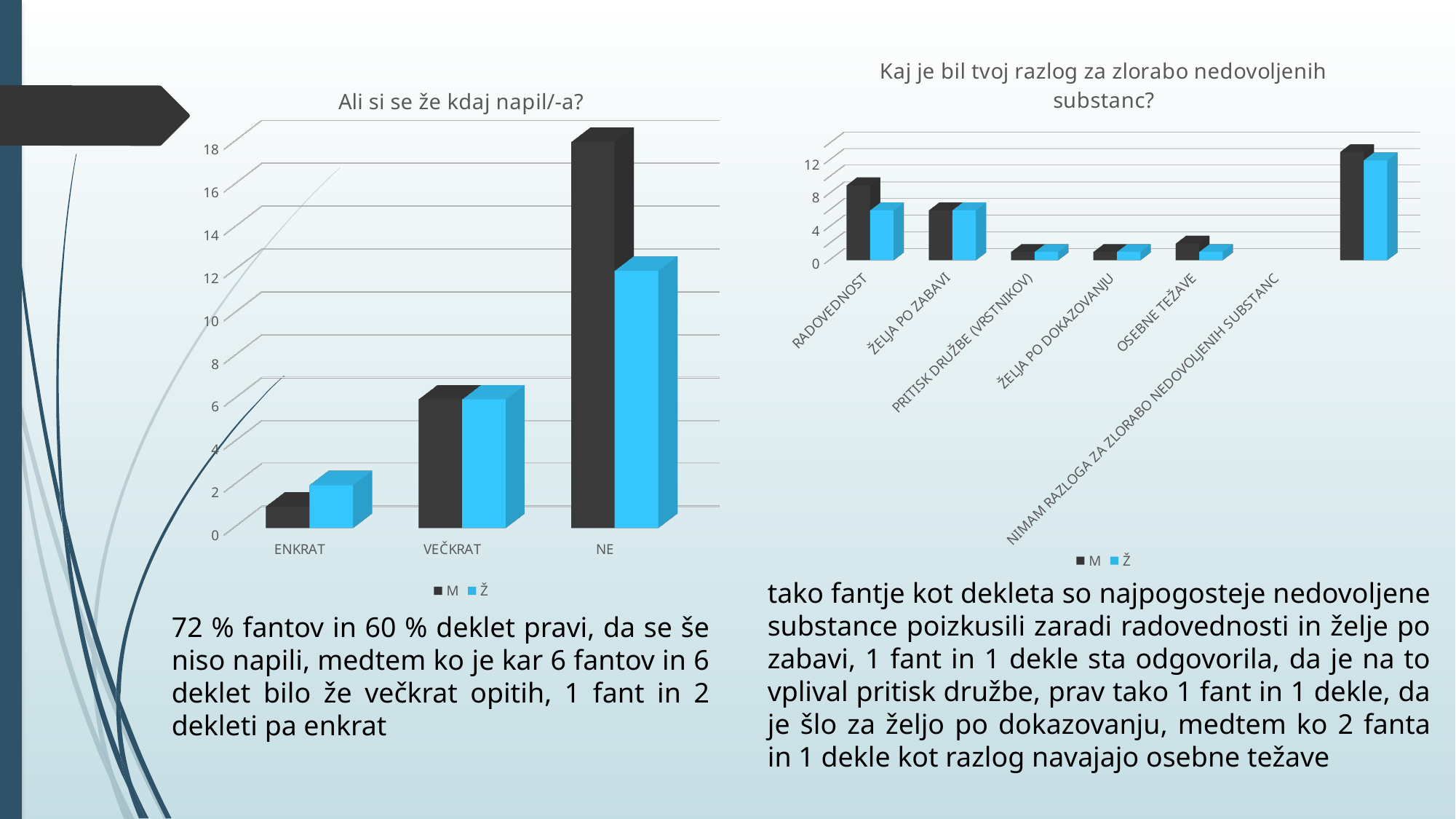
In the chart "Ali si se že kdaj napil/-a?", is the value of M for NE greater or less than 16? greater In the chart "Ali si se že kdaj napil/-a?", how many categories are shown on the x axis? 3 In the chart "Ali si se že kdaj napil/-a?", for the category NE, which series is larger, M or Ž? M In the chart "Kaj je bil tvoj razlog za zlorabo nedovoljenih substanc?", for RADOVEDNOST, which series is larger, M or Ž? M What kind of chart is the left chart titled "Ali si se že kdaj napil/-a?"? bar chart In the chart "Ali si se že kdaj napil/-a?", what is the value of M for VEČKRAT? 6 In the chart "Ali si se že kdaj napil/-a?", what is the value of Ž for ENKRAT? 2 In the chart "Ali si se že kdaj napil/-a?", which category has the highest value for M? NE In the chart "Ali si se že kdaj napil/-a?", how many series does the legend list? 2